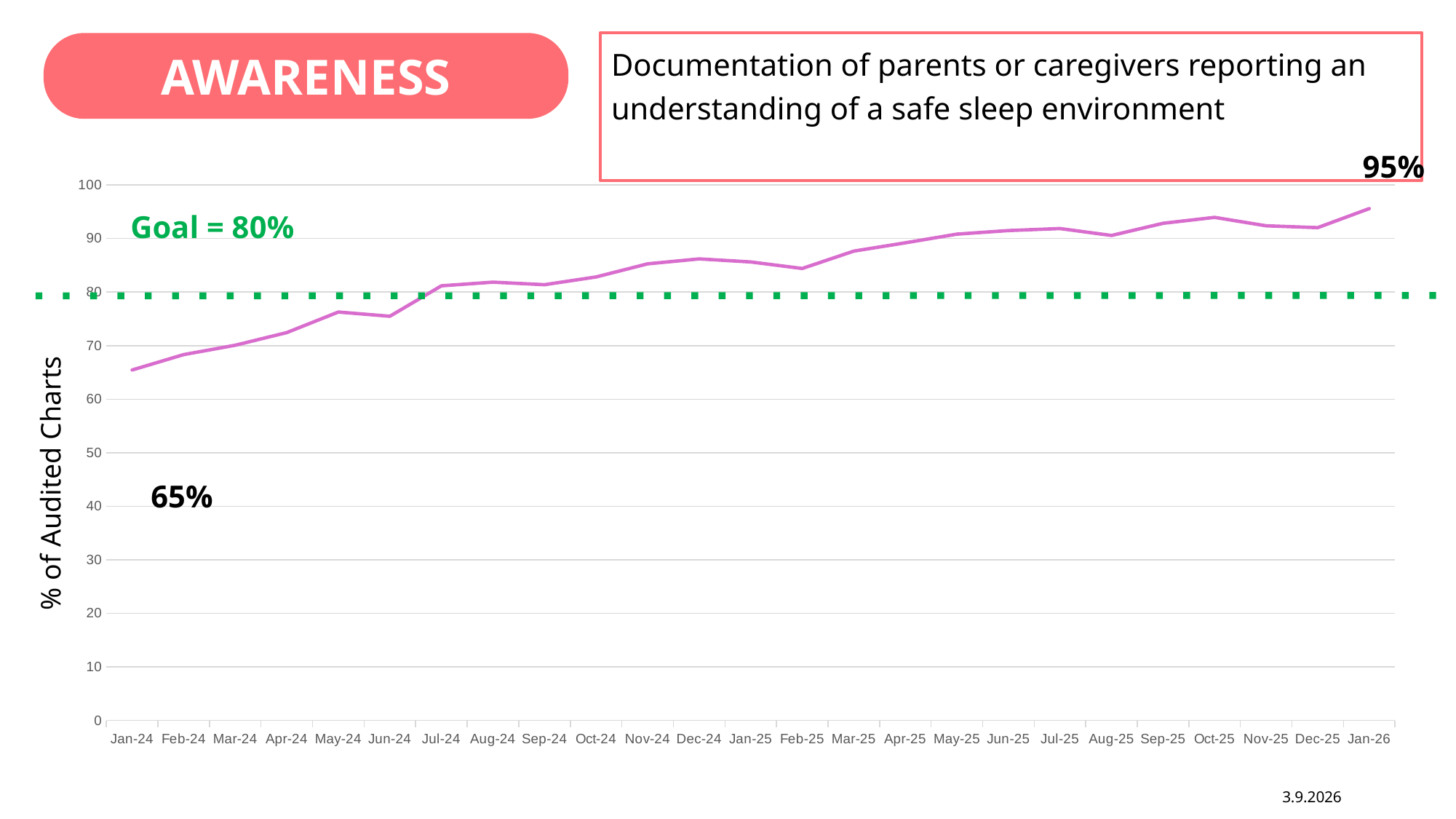
What goal value is marked by the dashed green line? 80% Is the value for Oct-25 greater or less than 90? greater Which month has the lowest value? Jan-24 What is the value for Jan-26? 95% Is the value for Jun-24 greater or less than 80? less What is the difference between the Jan-26 value and the Jan-24 value? 30% Do the values generally rise or fall from Jan-24 to Jan-26? rise Which month has the highest value? Jan-26 How many months are plotted on the x axis? 25 What is the value for Jan-24? 65% Is the value for Dec-24 greater or less than 80? greater What kind of chart is shown on the slide? line chart